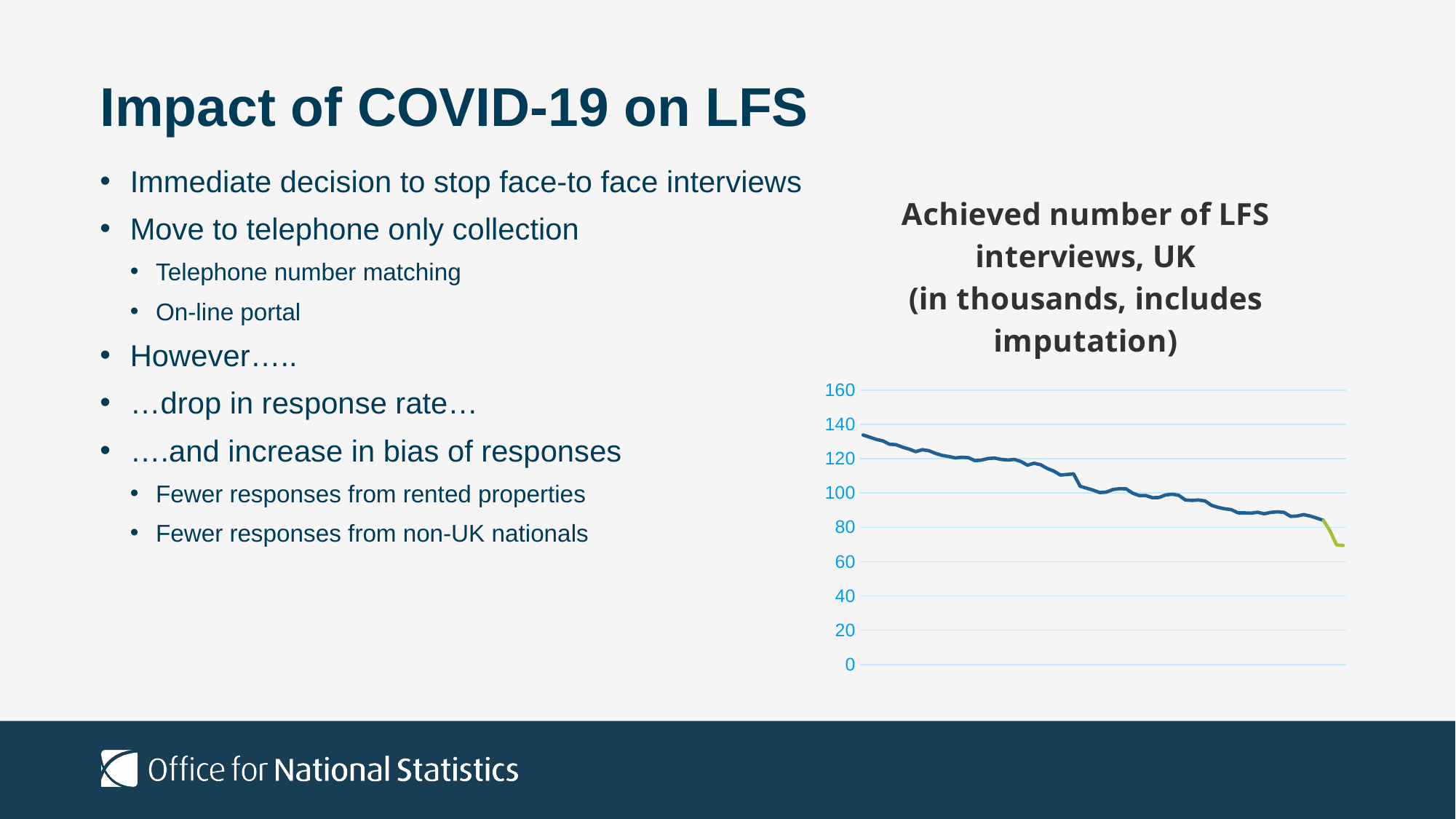
Is the value at the end of the line greater or less than 80? less Is the value at the start of the line greater or less than 120? greater What kind of chart is shown on the slide? line chart What is the title of the chart? Achieved number of LFS interviews, UK (in thousands, includes imputation) What is the highest value shown on the y axis? 160 Do the values in the chart rise or fall along the x axis? fall Is the value at the start of the line larger or smaller than the value at the end of the line? larger Is the highest value on the line greater or less than 140? less